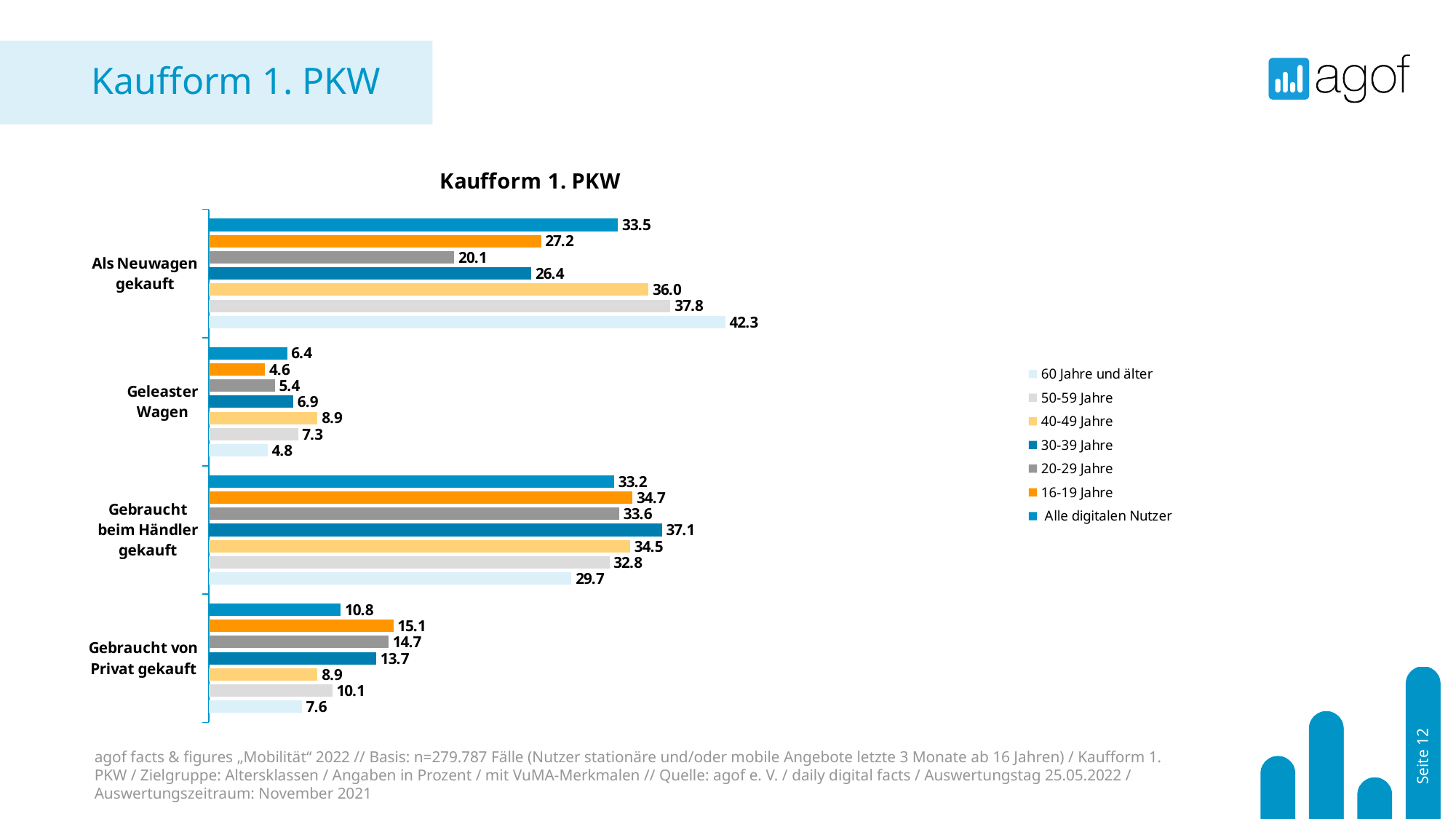
What is the value for '40-49 Jahre' in the 'Geleaster Wagen' category? 8.9 Which age group has the lowest value in the 'Geleaster Wagen' category? 16-19 Jahre Which age group has the highest value in the 'Als Neuwagen gekauft' category? 60 Jahre und älter What is the value for 'Alle digitalen Nutzer' in the 'Gebraucht beim Händler gekauft' category? 33.2 What kind of chart is shown on the slide? Bar chart In the 'Gebraucht von Privat gekauft' category, which is larger: the value for '16-19 Jahre' or for '60 Jahre und älter'? 16-19 Jahre What is the difference between the '60 Jahre und älter' and '20-29 Jahre' values in the 'Als Neuwagen gekauft' category? 22.2 What is the title of the chart? Kaufform 1. PKW How many purchase-form categories are shown on the chart? 4 What is the value for '60 Jahre und älter' in the 'Als Neuwagen gekauft' category? 42.3 What is the value for '16-19 Jahre' in the 'Gebraucht von Privat gekauft' category? 15.1 How many series does the legend list? 7